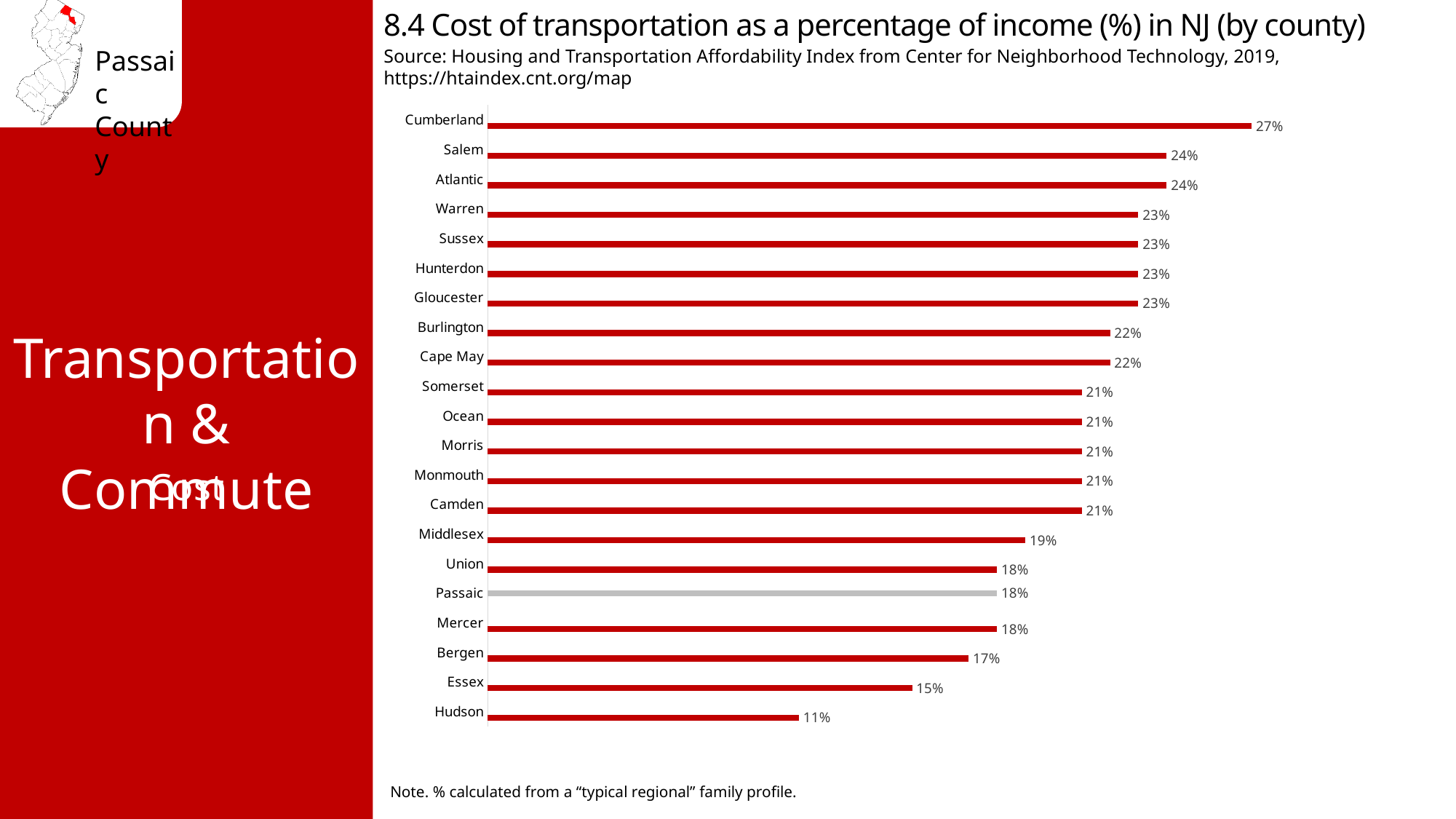
Which county has the highest cost of transportation as a percentage of income? Cumberland Which county has the lowest cost of transportation as a percentage of income? Hudson What is the cost of transportation as a percentage of income for Cumberland county? 27% What is the difference in percentage points between Cumberland and Hudson? 16 What is the cost of transportation as a percentage of income for Hudson county? 11% Which county has a higher cost of transportation as a percentage of income, Middlesex or Essex? Middlesex How many counties are shown in the chart? 21 Which county's bar is shown in a different colour (grey) from the others? Passaic What type of chart is shown on the slide? Bar chart What is the cost of transportation as a percentage of income for Passaic county? 18% What is the difference in percentage points between Passaic and Essex? 3 What is the cost of transportation as a percentage of income for Bergen county? 17%